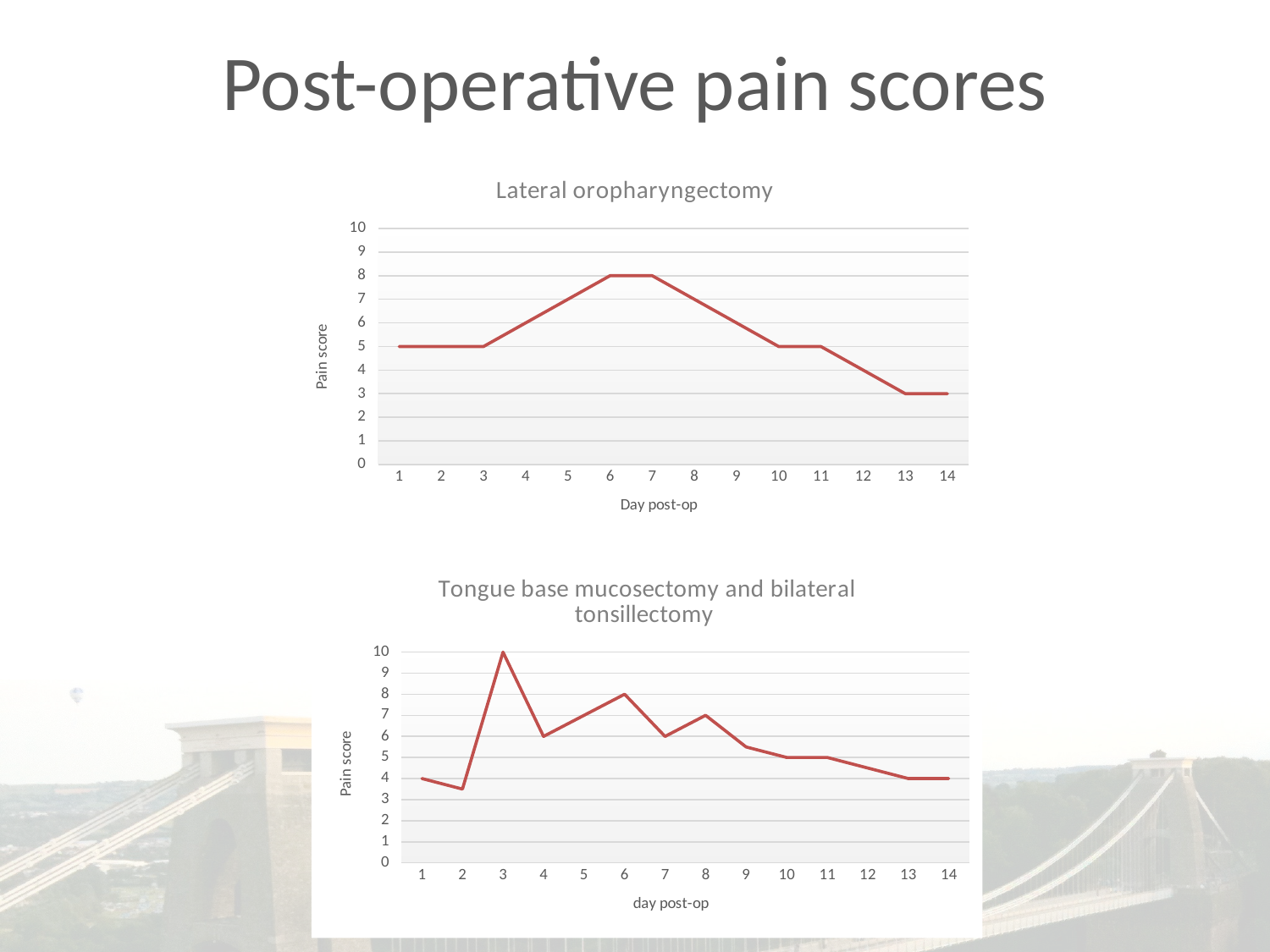
In the 'Lateral oropharyngectomy' chart, is the pain score on day 7 greater or less than 6? greater In the 'Lateral oropharyngectomy' chart, what is the pain score on day 14? 3 In the 'Lateral oropharyngectomy' chart, what is the pain score on day 6? 8 In the 'Lateral oropharyngectomy' chart, how many days post-op are plotted on the x axis? 14 In the 'Tongue base mucosectomy and bilateral tonsillectomy' chart, on which day is the pain score highest? Day 3 What is the label on the y axis of the 'Lateral oropharyngectomy' chart? Pain score In the 'Tongue base mucosectomy and bilateral tonsillectomy' chart, what is the pain score on day 3? 10 What kind of chart is the 'Lateral oropharyngectomy' chart? line chart In the 'Tongue base mucosectomy and bilateral tonsillectomy' chart, is the pain score on day 2 greater or less than 5? less In the 'Lateral oropharyngectomy' chart, on which days does the pain score reach its highest value? Days 6 and 7 In the 'Lateral oropharyngectomy' chart, what is the pain score on day 1? 5 In the 'Tongue base mucosectomy and bilateral tonsillectomy' chart, which day has the higher pain score, day 6 or day 7? Day 6